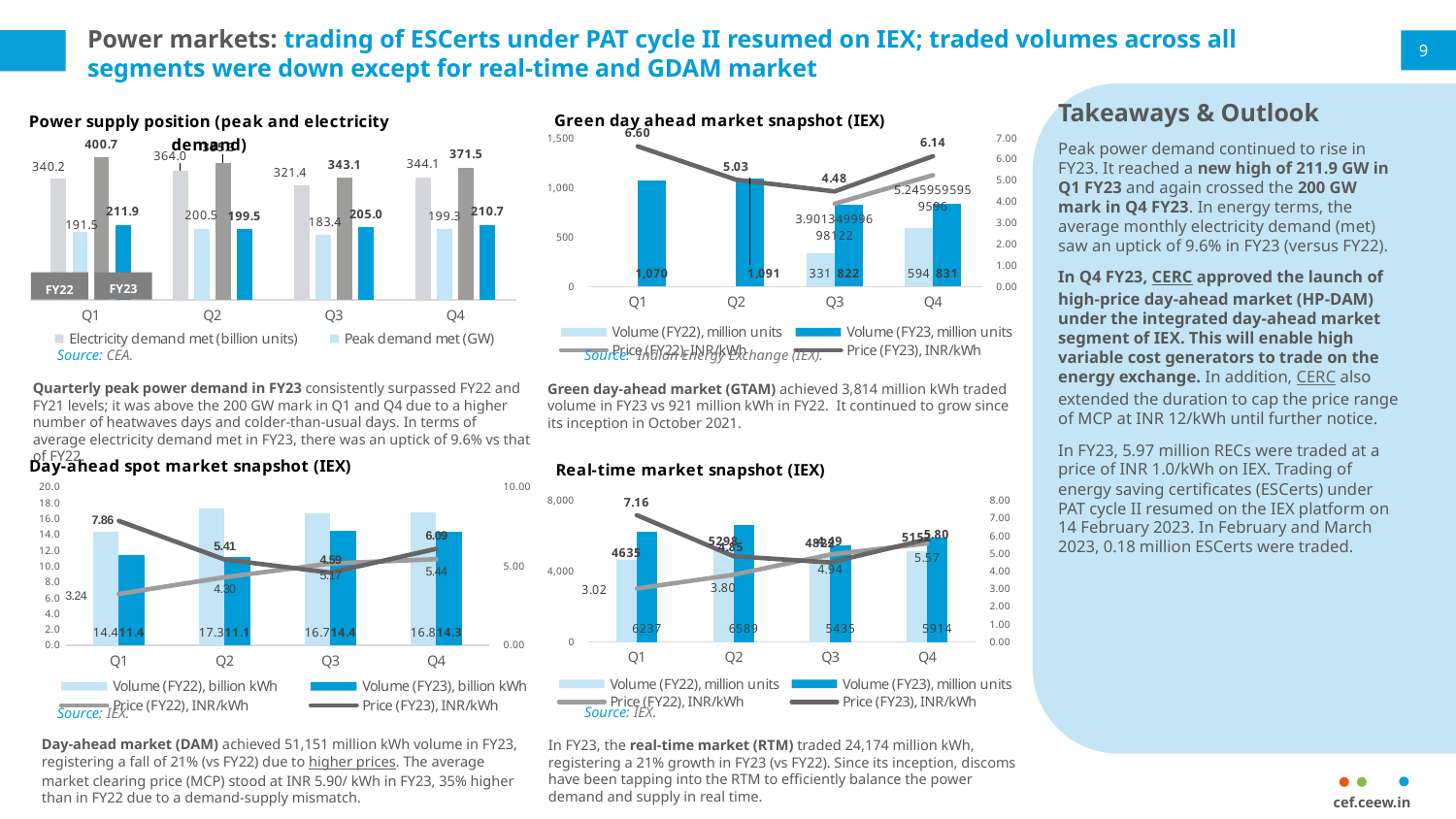
In the 'Green day ahead market snapshot (IEX)' chart, which quarter has the lowest FY23 price? Q3 In the 'Power supply position' chart, which quarter has the highest FY23 electricity demand met? Q1 In the 'Day-ahead spot market snapshot (IEX)' chart, how many series does the legend list? 4 In the 'Real-time market snapshot (IEX)' chart, does the FY22 price rise or fall from Q1 to Q4? rise In the 'Day-ahead spot market snapshot (IEX)' chart, what is the FY22 volume (billion kWh) in Q2? 17.3 In the 'Power supply position' chart, what is the difference between FY23 and FY22 peak demand met in Q3? 21.6 In the 'Power supply position' chart, what is the FY23 peak demand met (GW) in Q1? 211.9 In the 'Day-ahead spot market snapshot (IEX)' chart, which is larger: the FY23 price in Q1 or the FY23 price in Q4? FY23 price in Q1 In the 'Real-time market snapshot (IEX)' chart, what is the FY23 volume (million units) in Q2? 6589 In the 'Power supply position' chart, what is the FY22 electricity demand met (billion units) in Q4? 344.1 In the 'Green day ahead market snapshot (IEX)' chart, what is the FY23 price (INR/kWh) in Q1? 6.60 In the 'Green day ahead market snapshot (IEX)' chart, what is the FY23 volume (million units) in Q2? 1,091